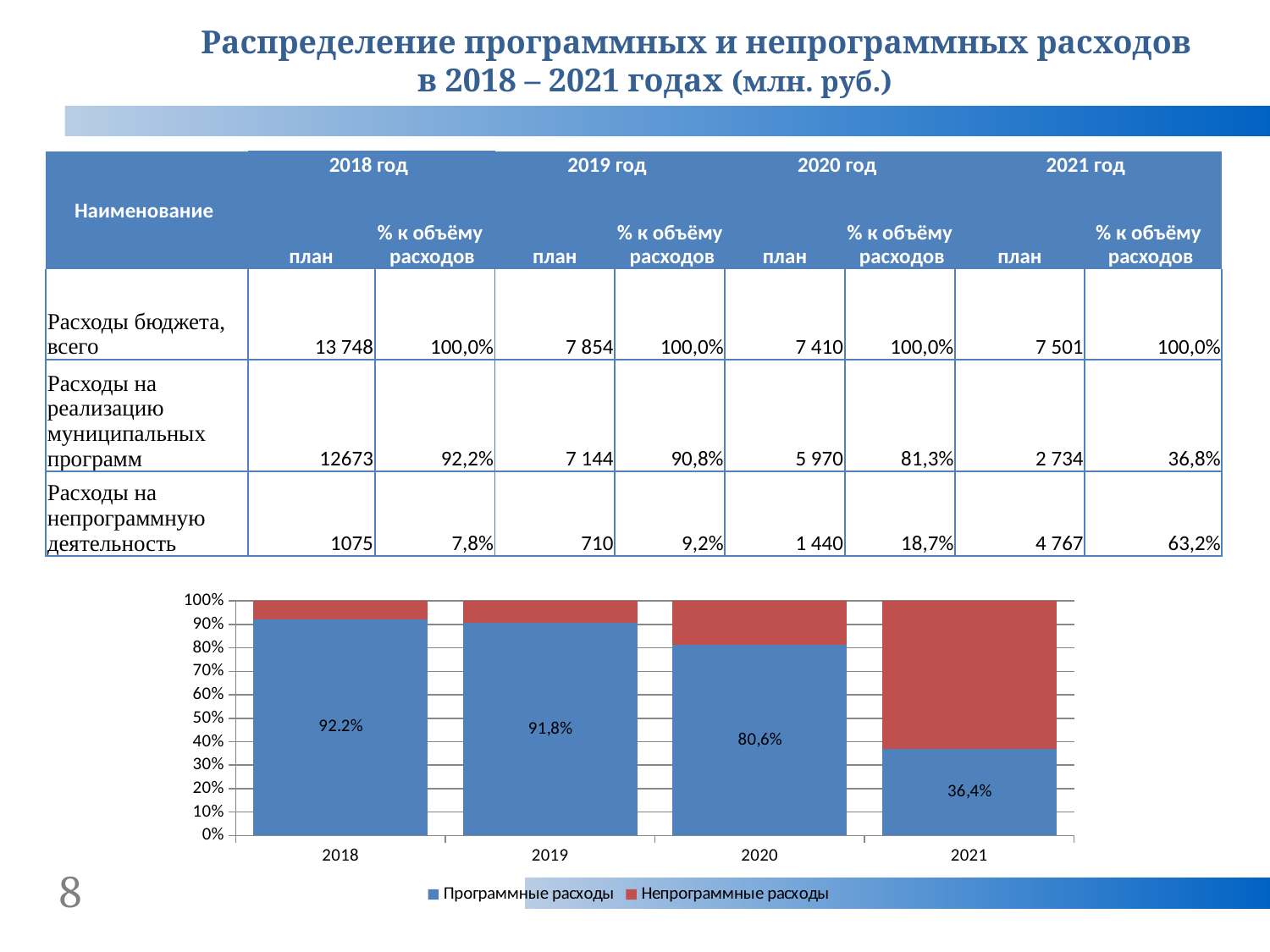
What is the value labelled for Программные расходы in 2018 on the chart? 92.2% What type of chart is shown on the slide? stacked bar chart Does the share of Программные расходы rise or fall from 2018 to 2021 on the chart? fall Which is larger on the chart: the share of Программные расходы in 2019 or in 2020? 2019 How many series does the chart legend list? 2 Is the share of Непрограммные расходы in 2021 greater or less than 60%? greater In which year is the share of Программные расходы highest on the chart? 2018 What is the value labelled for Программные расходы in 2021 on the chart? 36,4% In which year is the share of Программные расходы lowest on the chart? 2021 What is the value labelled for Программные расходы in 2019 on the chart? 91,8% What is the value labelled for Программные расходы in 2020 on the chart? 80,6% How many years are shown on the x axis of the chart? 4